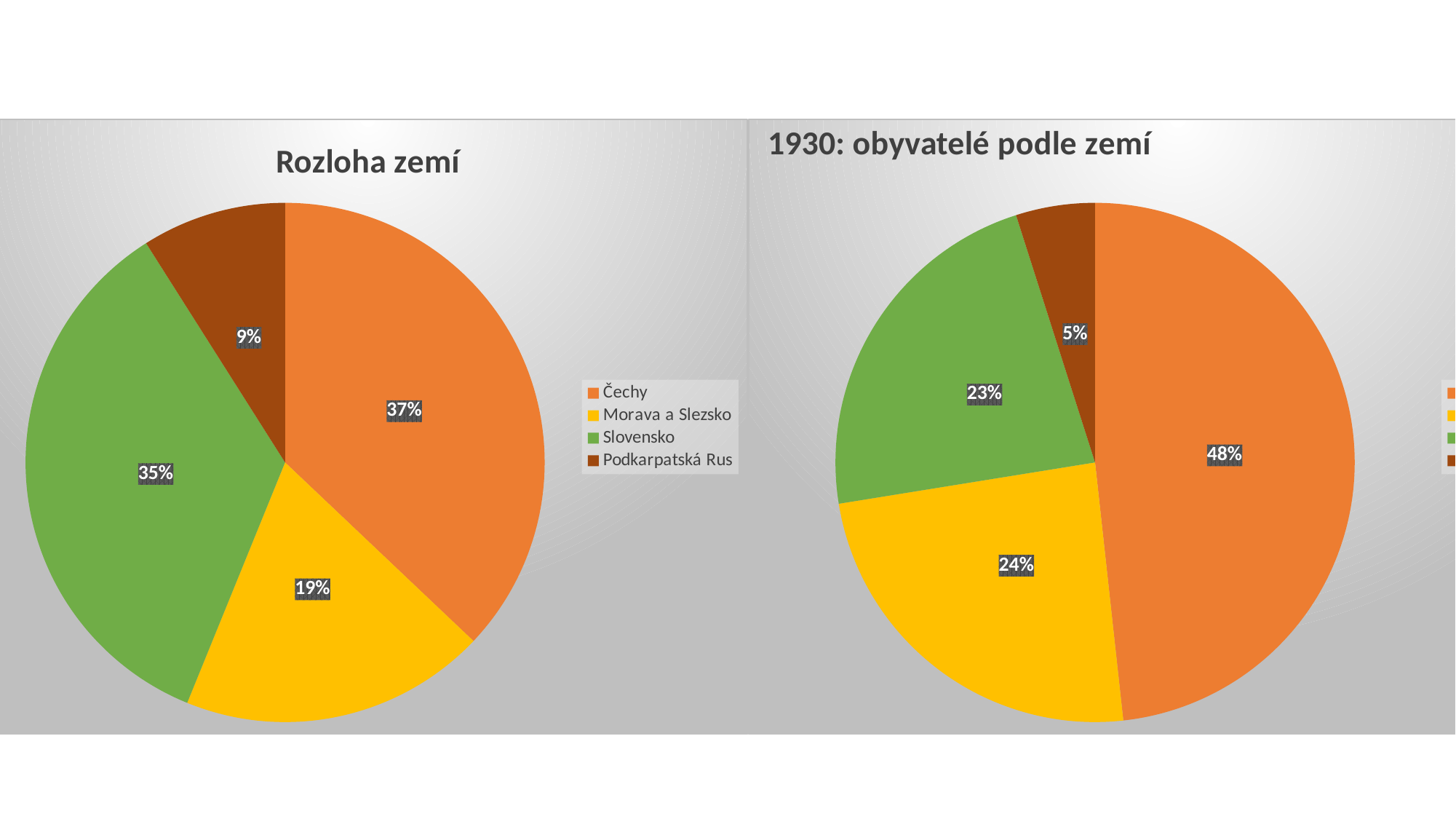
In the chart titled "1930: obyvatelé podle zemí", which is larger, the yellow slice or the green slice? the yellow slice What is the title of the chart on the left side of the slide? Rozloha zemí In the chart titled "Rozloha zemí", how many categories does the legend list? 4 In the chart titled "Rozloha zemí", which category has the smallest share? Podkarpatská Rus In the chart titled "Rozloha zemí", what share does Čechy have? 37% In the chart titled "Rozloha zemí", what is the difference in percentage points between Slovensko and Morava a Slezsko? 16 In the chart titled "Rozloha zemí", which category has the largest share? Čechy In the chart titled "Rozloha zemí", what share does Podkarpatská Rus have? 9% In the chart titled "1930: obyvatelé podle zemí", what share does the orange slice have? 48% What kind of chart is the chart titled "1930: obyvatelé podle zemí"? pie chart In the chart titled "1930: obyvatelé podle zemí", what share does the brown slice have? 5% In the chart titled "Rozloha zemí", what share does Slovensko have? 35%